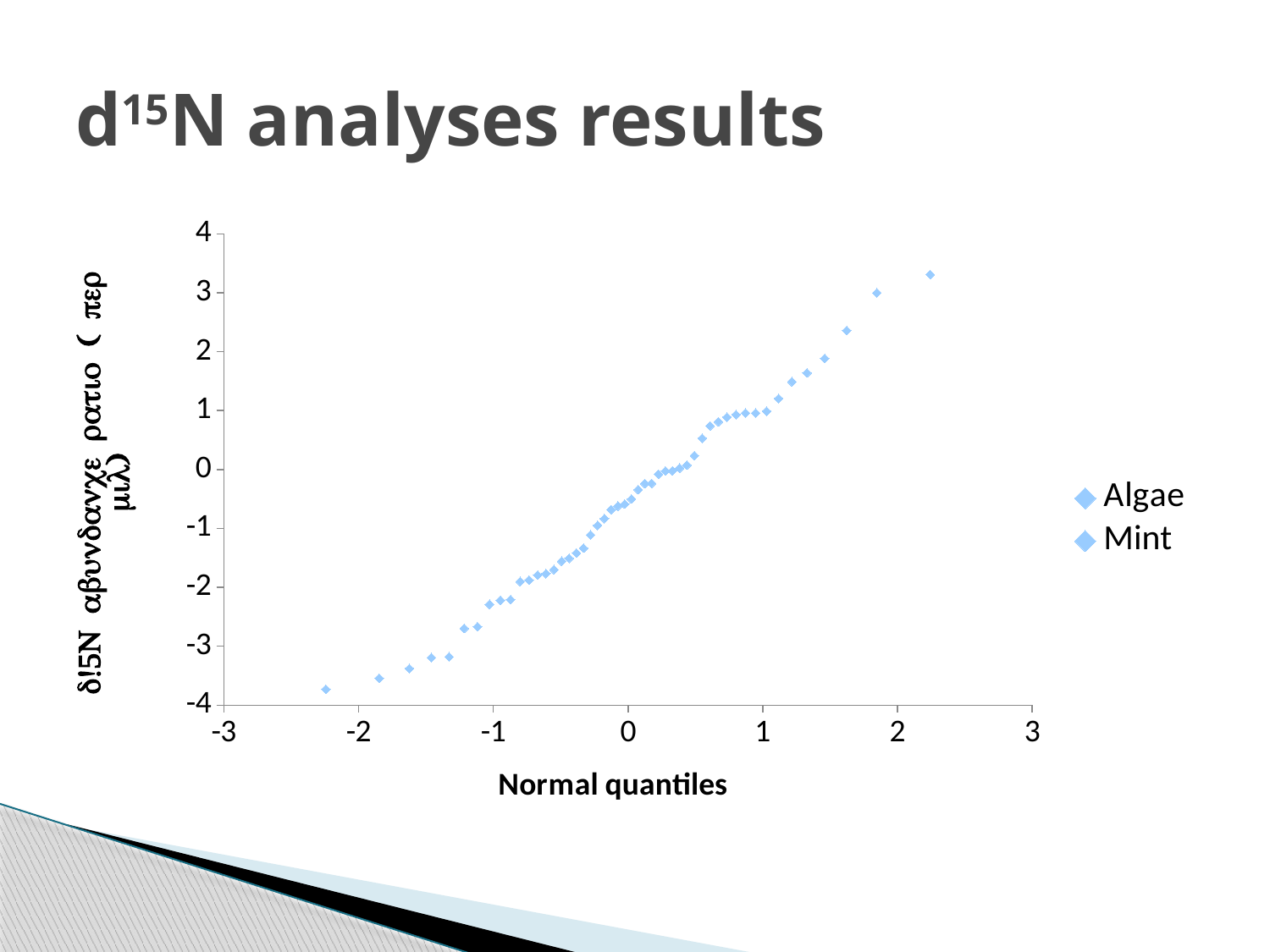
Is the y value of the point at normal quantile 1 greater or less than 2? less What kind of chart is shown on the slide? scatter chart Is the lowest plotted y value greater or less than -4? greater What are the two series named in the legend? Algae and Mint Is the highest plotted y value greater or less than 4? less What is the title of the x axis? Normal quantiles How many series does the legend list? 2 Do the plotted values rise or fall as the normal quantile increases along the x axis? rise What is the maximum value shown on the x axis? 3